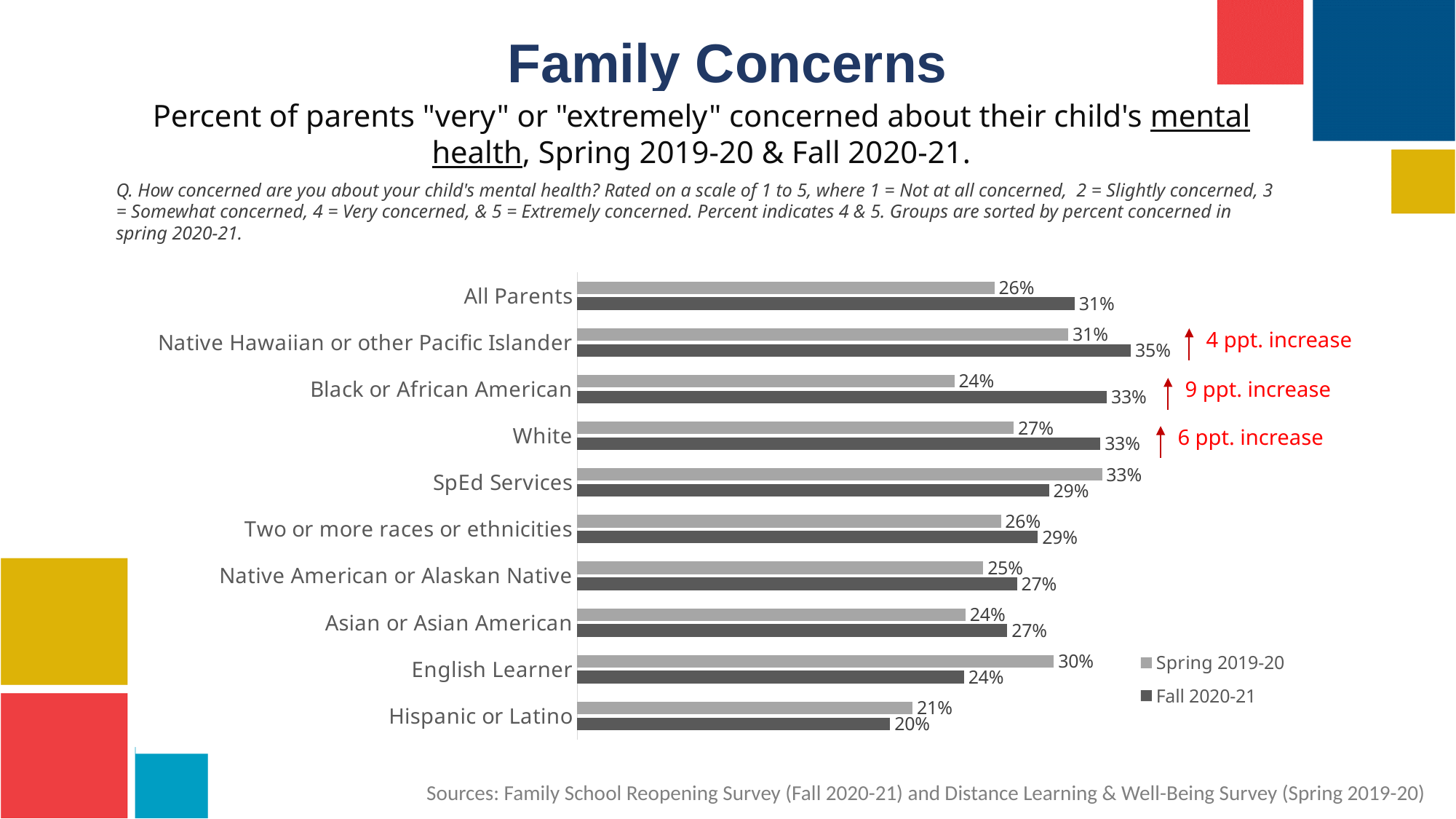
Which category has the highest Spring 2019-20 value? SpEd Services Which is larger for English Learner: the Spring 2019-20 value or the Fall 2020-21 value? Spring 2019-20 What is the difference between the Fall 2020-21 and Spring 2019-20 values for Black or African American? 9 ppt. What is the Spring 2019-20 value for English Learner? 30% What is the Fall 2020-21 value for Black or African American? 33% Which category has the highest Fall 2020-21 value? Native Hawaiian or other Pacific Islander What kind of chart is shown on the slide? Bar chart Which category has the lowest Fall 2020-21 value? Hispanic or Latino What are the two series listed in the legend? Spring 2019-20 and Fall 2020-21 What is the Fall 2020-21 value for All Parents? 31% How many categories are shown on the chart? 10 How many series does the legend list? 2